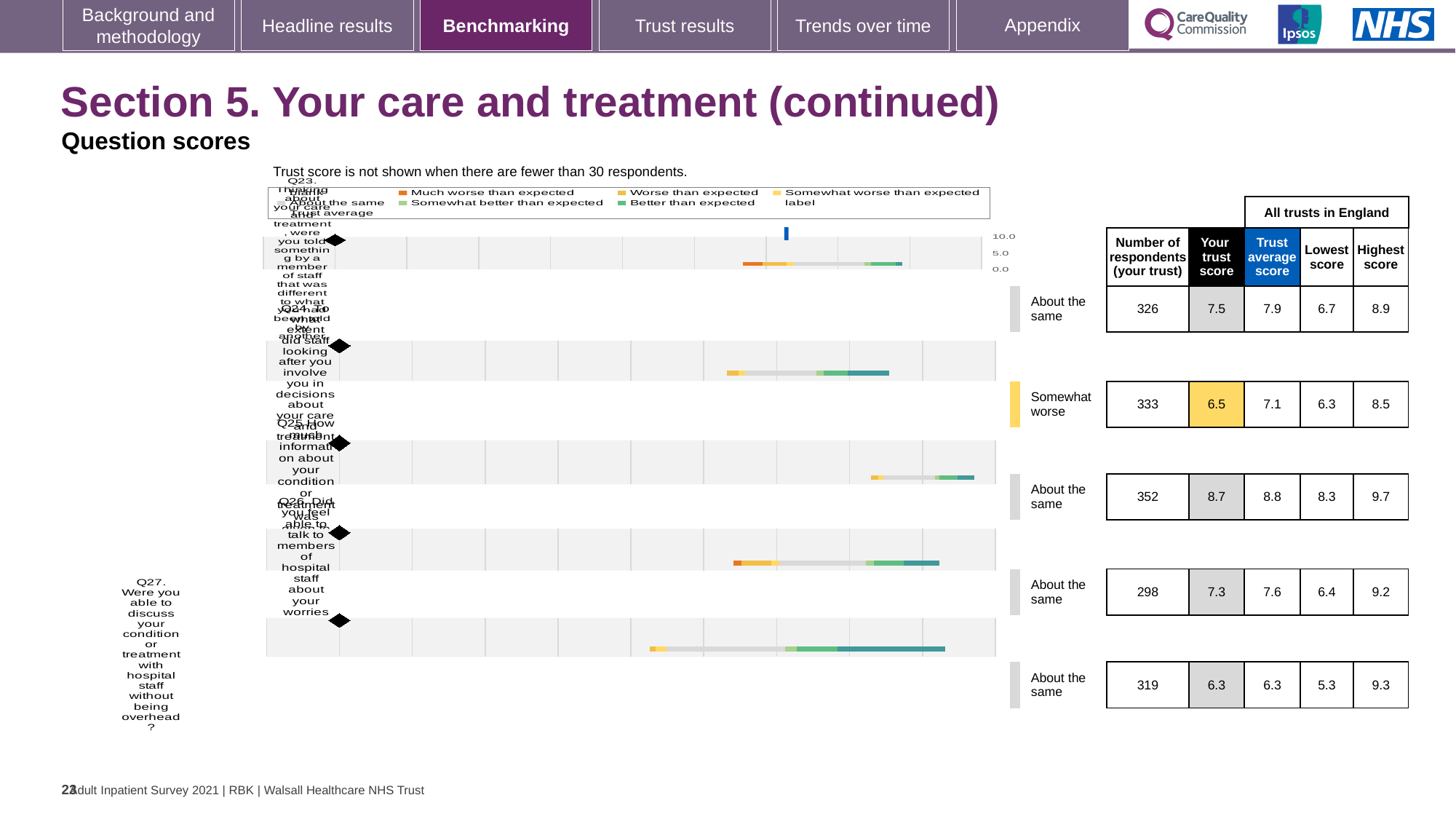
Which question is rated 'Somewhat worse' than expected? Q24 What is the number of respondents for Q27 (discussing your condition or treatment without being overheard)? 319 Which question has the highest trust score? Q25 Which question has the lowest trust score? Q27 What is the trust average score for Q23? 7.9 What is the difference between the trust average score and the trust score for Q24? 0.6 What is the highest score across all trusts in England for Q25? 9.7 How many survey questions (Q23 to Q27) are plotted on the chart? 5 What kind of chart is shown on the slide? bar chart What is the lowest score across all trusts in England for Q26? 6.4 What is the trust score for Q24 (involving you in decisions about your care and treatment)? 6.5 Which is larger for Q26: the trust score or the trust average score? Trust average score